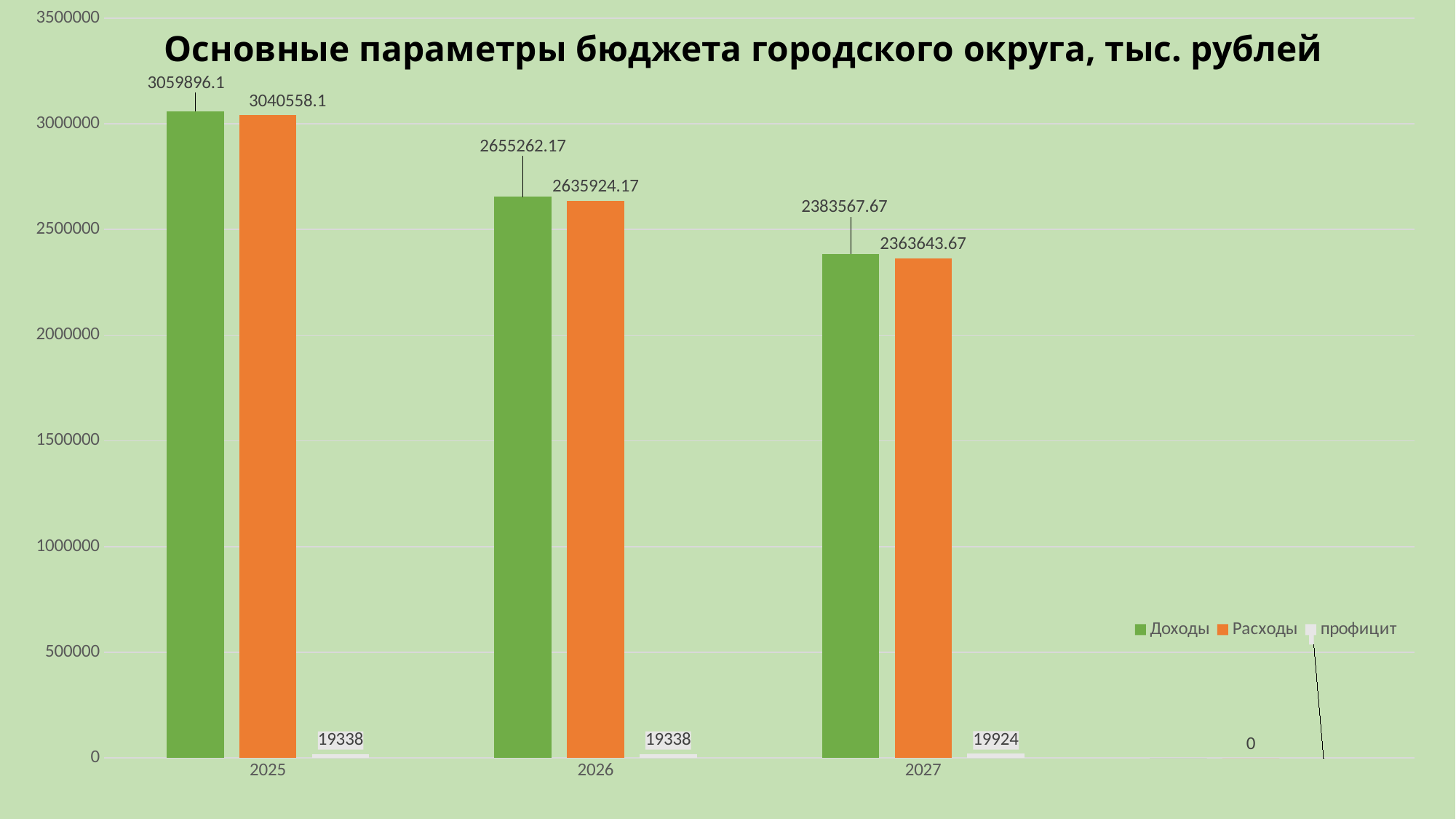
Which is larger in 2026: Доходы or Расходы? Доходы What kind of chart is shown on the slide? Bar chart What is the value of профицит for 2027? 19924 Which year has the lowest value of Расходы? 2027 What is the difference between Доходы in 2025 and Доходы in 2026? 404633.93 What is the value of Расходы for 2026? 2635924.17 Which year has the highest value of Доходы? 2025 What is the value of Расходы for 2027? 2363643.67 What is the difference between Доходы and Расходы in 2025? 19338 Do the values of Доходы rise or fall from 2025 to 2027? Fall What is the value of Доходы for 2025? 3059896.1 How many series does the legend list? 3